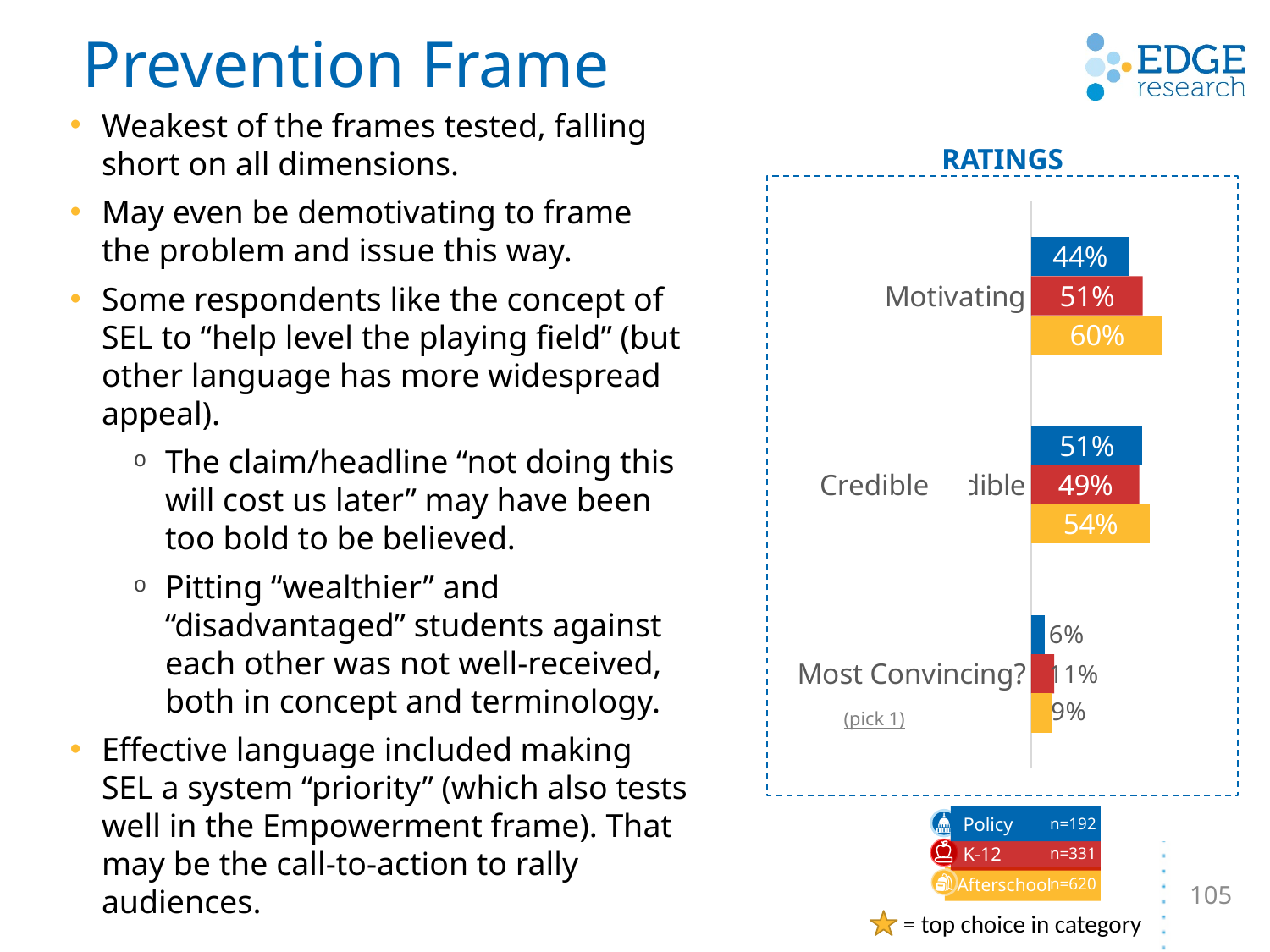
What kind of chart is the RATINGS chart? Bar chart What is the difference between the Afterschool and K-12 values for Credible in the RATINGS chart? 5% Which series has the lowest value for Most Convincing? in the RATINGS chart? Policy Which is larger for Credible in the RATINGS chart, the Policy value or the K-12 value? Policy What is the Policy value for Credible in the RATINGS chart? 51% How many series does the legend of the RATINGS chart list? 3 What is the K-12 value for Most Convincing? in the RATINGS chart? 11% What is the Afterschool value for Motivating in the RATINGS chart? 60% How many categories are shown in the RATINGS chart? 3 What is the difference between the Afterschool and Policy values for Motivating in the RATINGS chart? 16% Which series has the highest value for Motivating in the RATINGS chart? Afterschool What is the sample size (n) for the K-12 series in the RATINGS chart legend? n=331